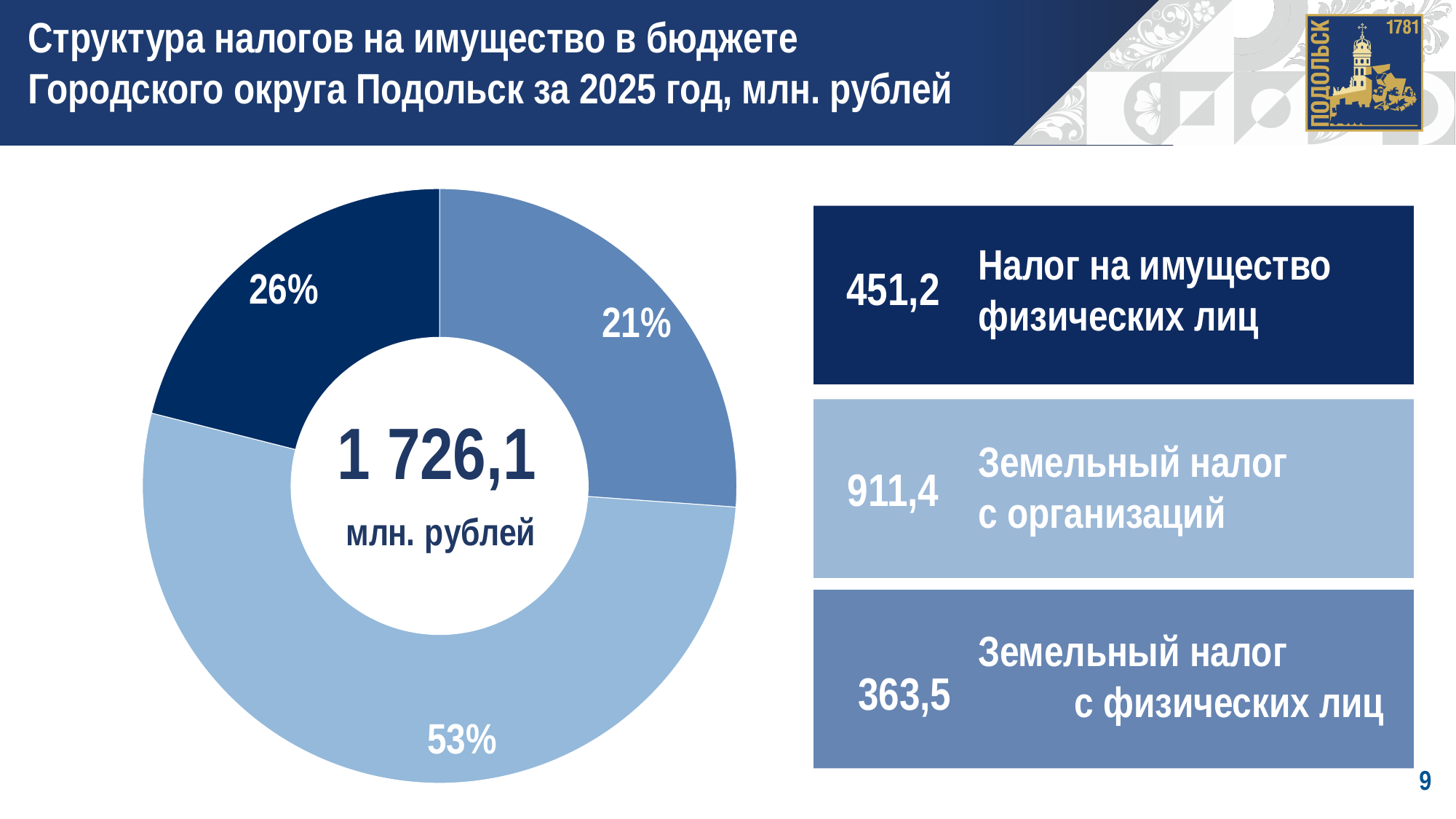
Which is larger: Налог на имущество физических лиц or Земельный налог с физических лиц? Налог на имущество физических лиц What share of the chart does Налог на имущество физических лиц represent? 26% What is the difference between Земельный налог с организаций and Налог на имущество физических лиц? 460,2 What is the value for Налог на имущество физических лиц? 451,2 How many categories does the chart show? 3 What kind of chart is shown on the slide? pie chart (donut) What is the total shown in the centre of the chart? 1 726,1 млн. рублей What is the value for Земельный налог с физических лиц? 363,5 Which category has the smallest value? Земельный налог с физических лиц What share of the chart does Земельный налог с организаций represent? 53% What is the value for Земельный налог с организаций? 911,4 Which category has the largest value? Земельный налог с организаций